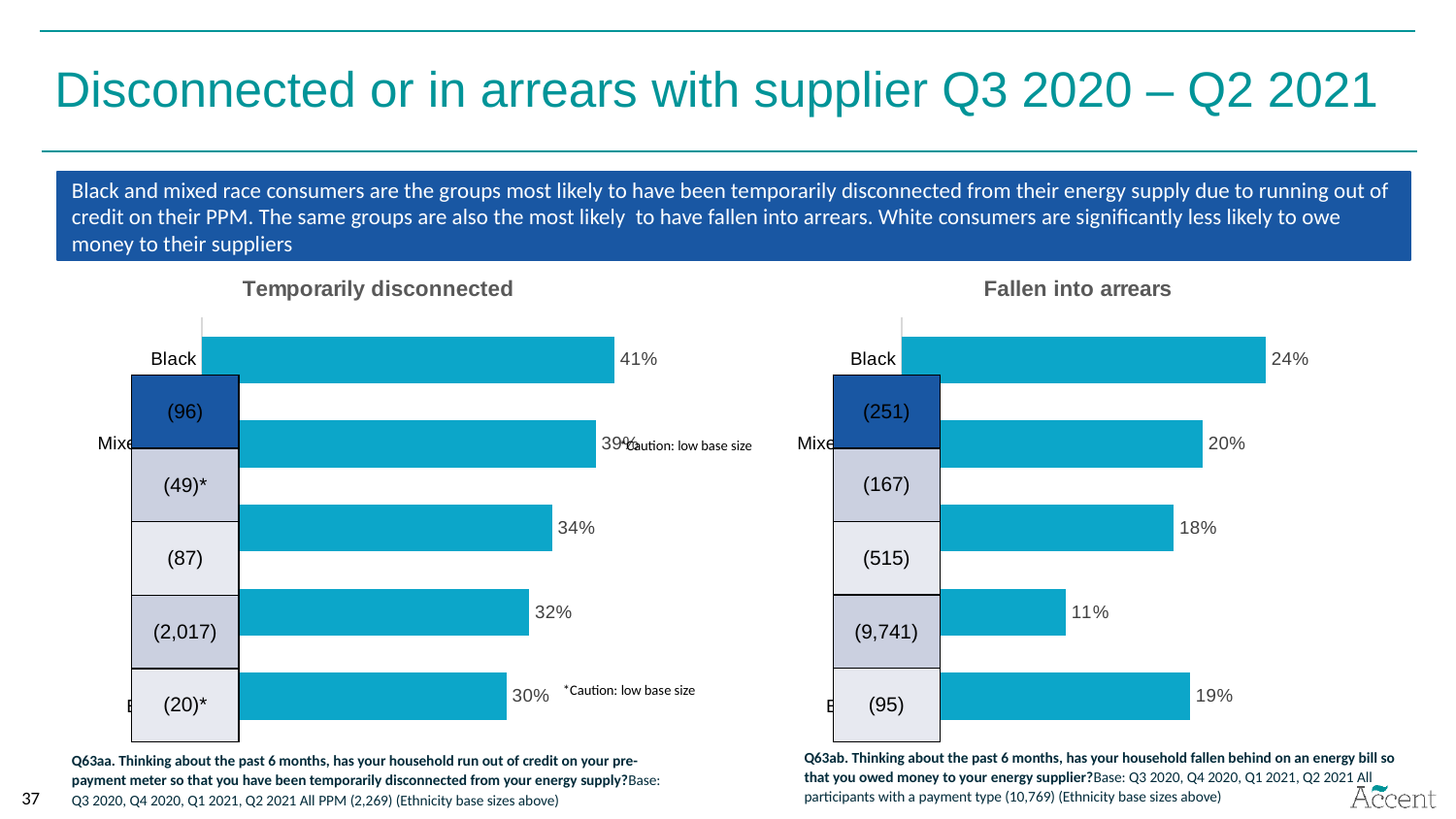
In the Fallen into arrears chart, what is the value for Black? 24% In the Fallen into arrears chart, which is larger, the value for Black or the value for Mixed? Black In the Temporarily disconnected chart, which category has the highest value? Black What type of chart is the Fallen into arrears chart? Bar chart In the Temporarily disconnected chart, what is the value for Black? 41% In the Fallen into arrears chart, what is the difference between the values for Black and Mixed? 4 percentage points In the Fallen into arrears chart, which category has the highest value? Black In the Fallen into arrears chart, what is the value for Mixed? 20% How many bars are shown in the Temporarily disconnected chart? 5 In the Fallen into arrears chart, what is the lowest value shown? 11% In the Temporarily disconnected chart, what is the difference between the values for Black and Mixed? 2 percentage points In the Temporarily disconnected chart, what is the value for Mixed? 39%